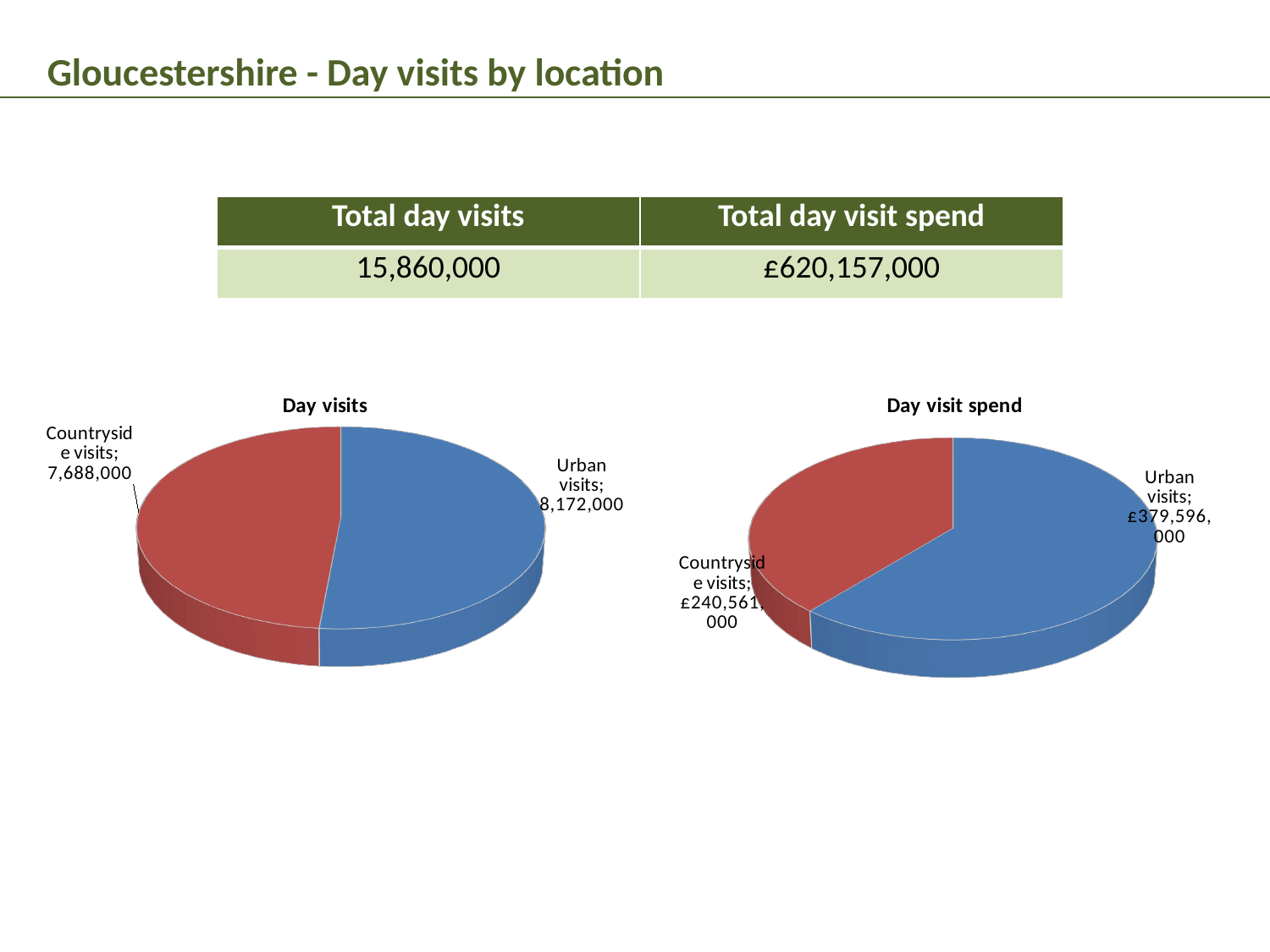
What is the title of the chart on the right of the slide? Day visit spend In the Day visits pie chart, which category has the smallest slice? Countryside visits In the Day visits pie chart, what is the value for Urban visits? 8,172,000 In the Day visit spend pie chart, what is the value for Urban visits? £379,596,000 In the Day visit spend pie chart, which category has the largest slice? Urban visits In the Day visits pie chart, what is the value for Countryside visits? 7,688,000 What type of chart is the Day visits chart? Pie chart In the Day visit spend pie chart, how much more is spent on Urban visits than on Countryside visits? £139,035,000 In the Day visit spend pie chart, what is the value for Countryside visits? £240,561,000 In the Day visits pie chart, what is the difference between Urban visits and Countryside visits? 484,000 In the Day visits pie chart, which is larger: Urban visits or Countryside visits? Urban visits How many slices does the Day visit spend pie chart have? 2